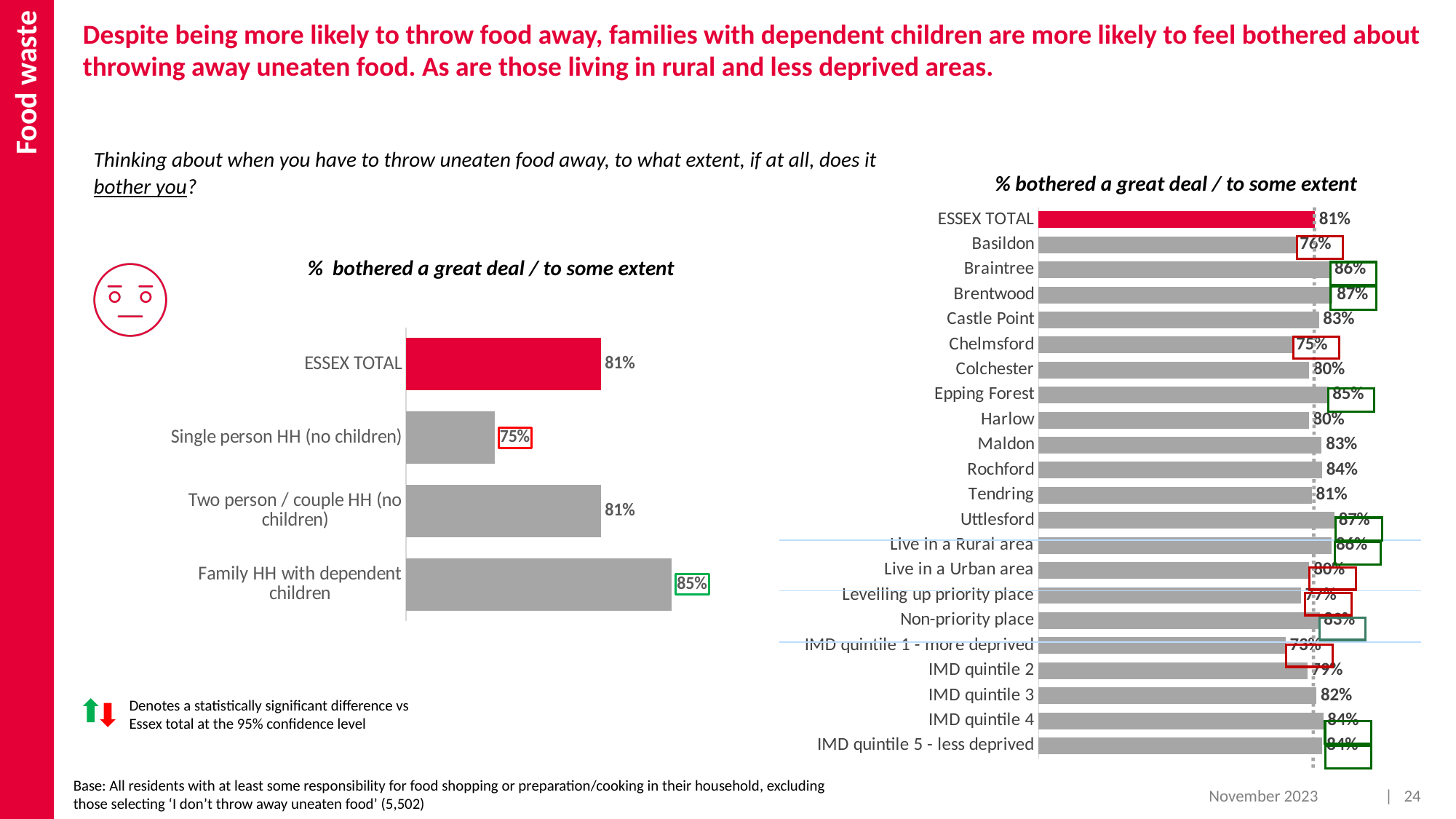
On the right chart, what colour is the ESSEX TOTAL bar? Red On the left chart, which category has the lowest value? Single person HH (no children) On the right chart, what is the value for Epping Forest? 85% On the left chart, what is the value for Single person HH (no children)? 75% On the left chart, what is the difference between Family HH with dependent children and Single person HH (no children)? 10 percentage points On the right chart, which is larger, Braintree or Basildon? Braintree How many categories are shown on the left chart? 4 On the right chart, what is the value for Chelmsford? 75% On the left chart, what is the value for Family HH with dependent children? 85% On the right chart, what is the difference between Rochford and Colchester? 4 percentage points On the right chart, what is the value for Brentwood? 87% What kind of chart is the left chart? Bar chart